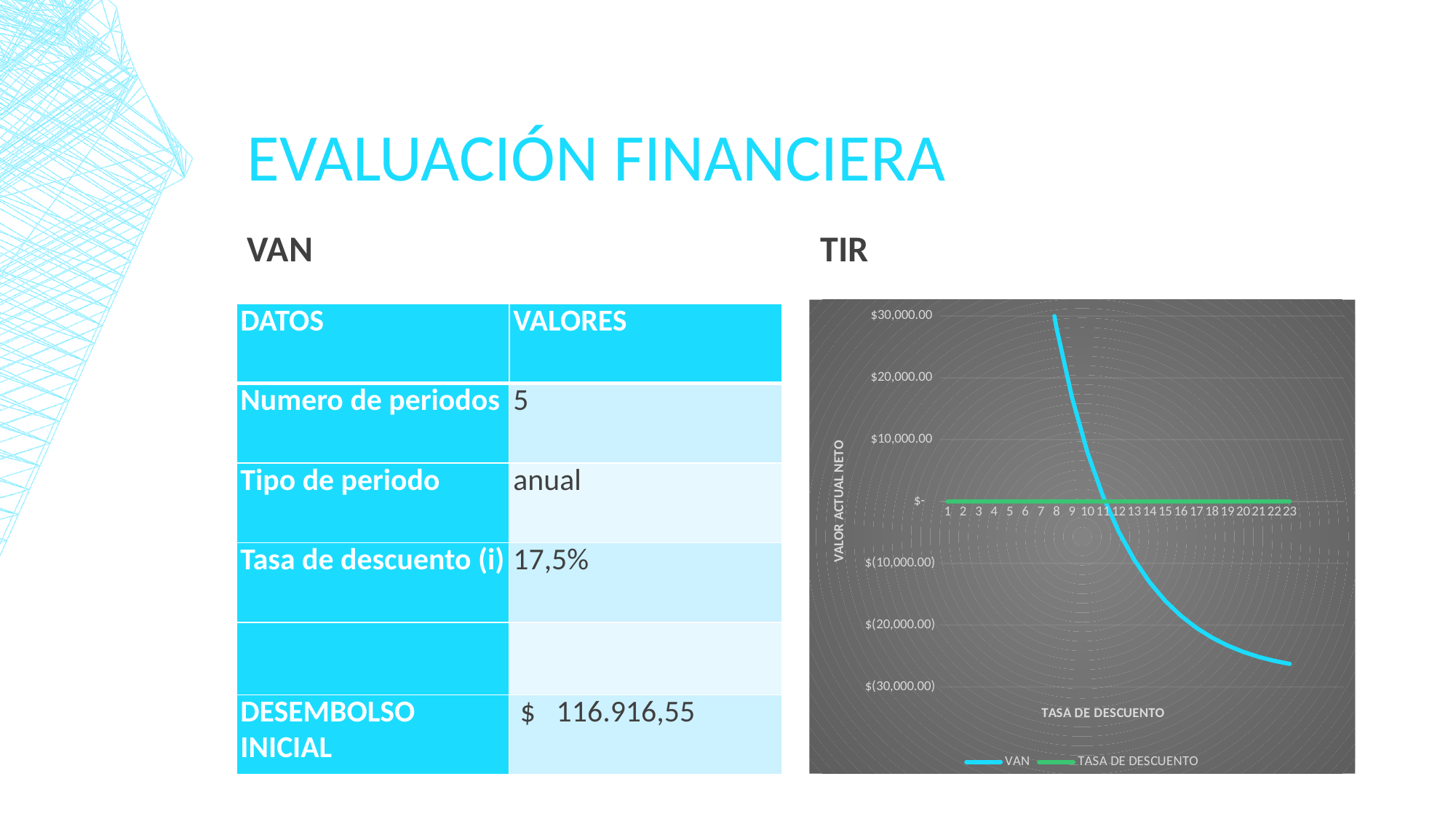
In the TIR chart, does the VAN series rise or fall as the x axis increases? fall How many series does the legend of the TIR chart list? 2 What are the two series named in the legend of the TIR chart? VAN and TASA DE DESCUENTO How many points are labelled along the x axis of the TIR chart? 23 In the TIR chart, is the VAN value at point 23 greater or less than $(20,000.00)? less What kind of chart is shown under the TIR heading? line chart In the TIR chart, which is larger: the VAN value at point 9 or at point 15? point 9 What is the title of the vertical axis of the TIR chart? VALOR ACTUAL NETO In the TIR chart, is the VAN value at point 15 greater or less than $-? less In the TIR chart, is the VAN value at point 8 greater or less than $20,000.00? greater In the TIR chart, at which x-axis point is the VAN series lowest? 23